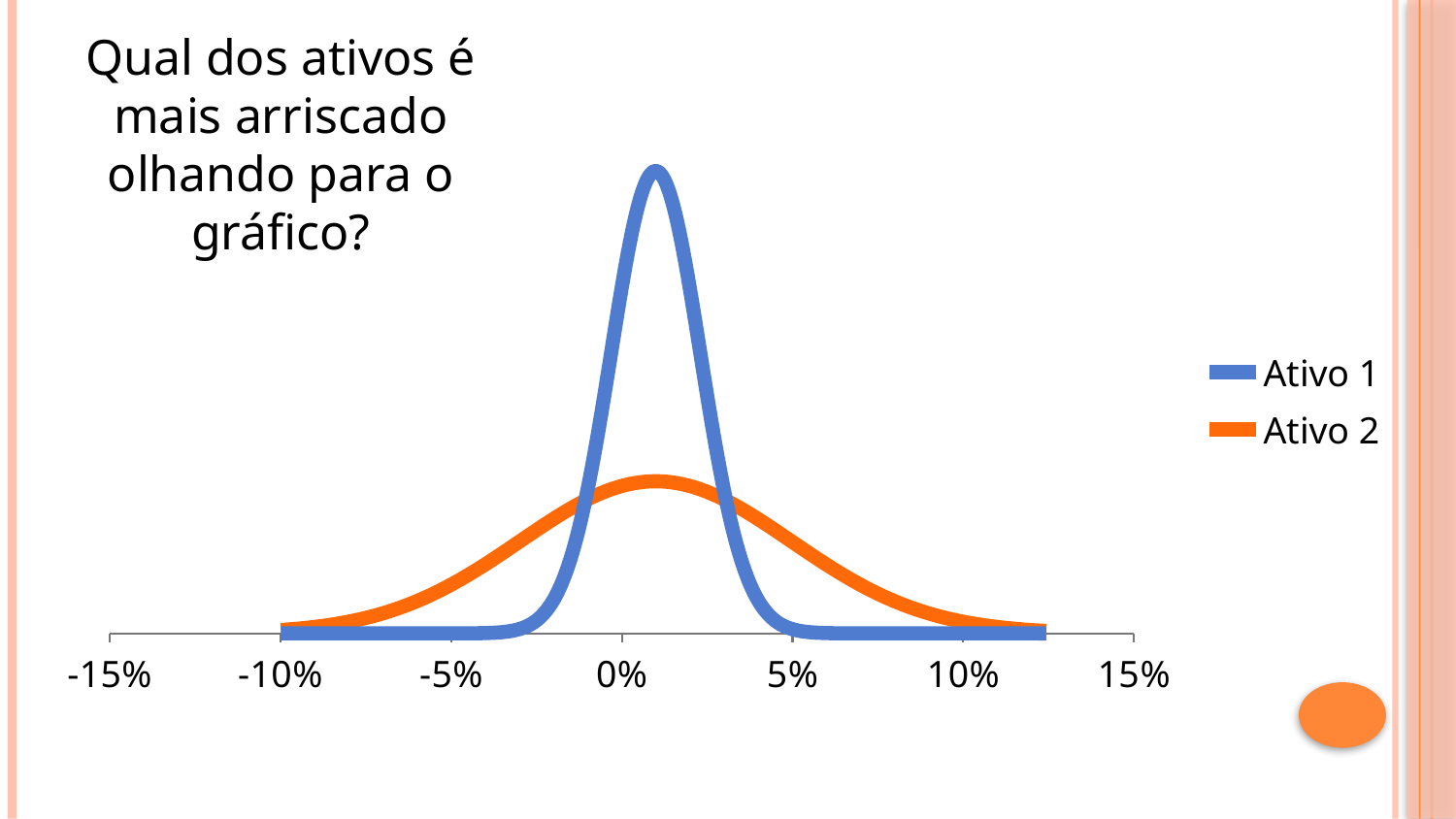
What is the lowest value labelled on the x axis? -15% What colour is the line for Ativo 1? blue Which series has the lower peak? Ativo 2 What kind of chart is shown on the slide? line chart How many tick labels are shown on the x axis? 7 Which series reaches the higher peak, Ativo 1 or Ativo 2? Ativo 1 What colour is the line for Ativo 2? orange What is the highest value labelled on the x axis? 15% Which series is spread more widely along the x axis, Ativo 1 or Ativo 2? Ativo 2 Which series has the highest point on the chart? Ativo 1 How many series does the legend list? 2